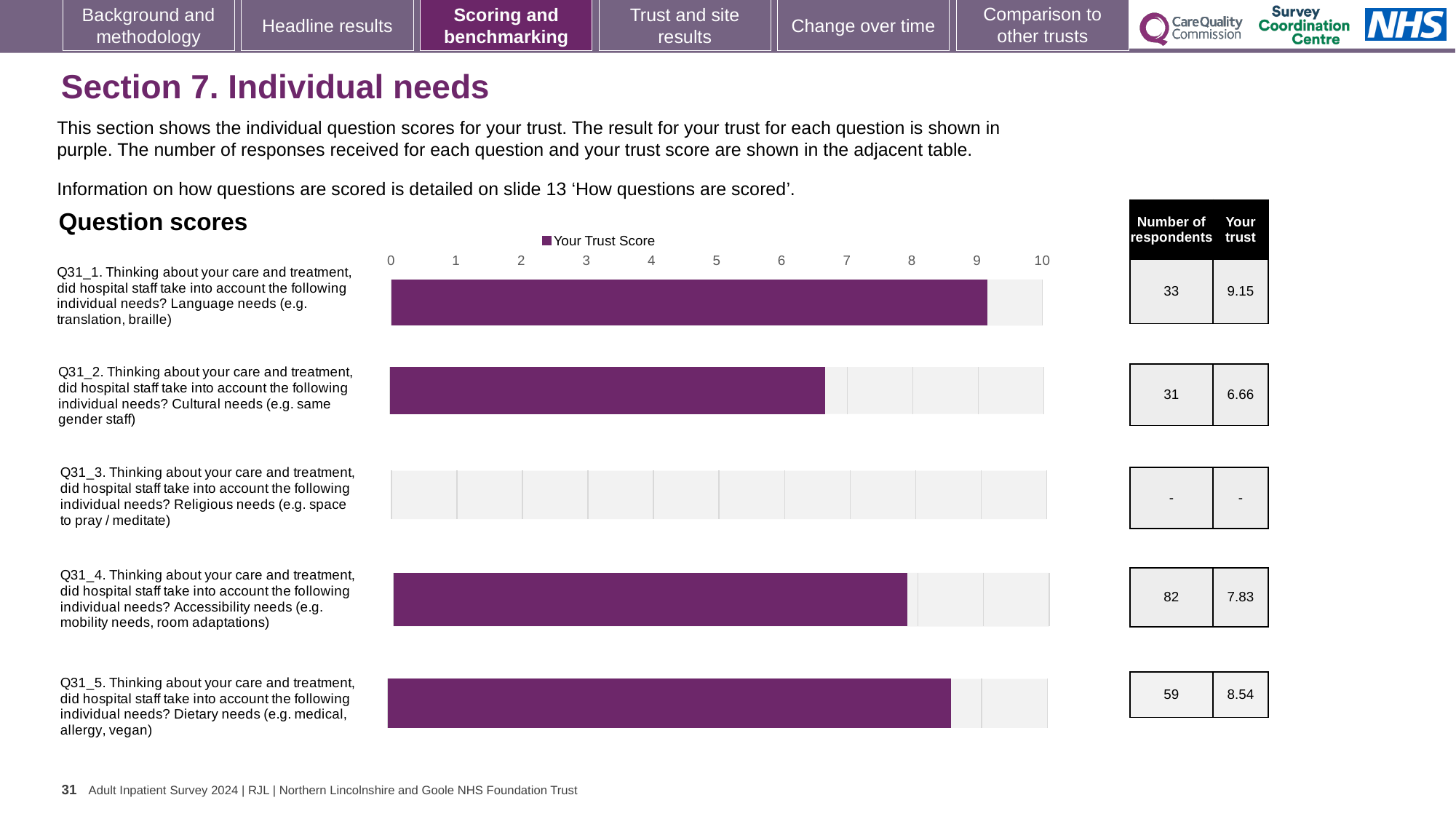
What type of chart is used to show the question scores? Bar chart What is the difference between the trust scores for Q31_1 and Q31_2? 2.49 Is the trust score for Q31_2 (Cultural needs) greater or less than 7? less Among the questions with a score shown, which has the lowest trust score? Q31_2 (Cultural needs) What is the trust score for Q31_2 (Cultural needs)? 6.66 Which question has the highest trust score? Q31_1 (Language needs) What is the trust score for Q31_5 (Dietary needs)? 8.54 How many respondents answered Q31_4 (Accessibility needs)? 82 How many questions are listed in the chart? 5 What is the trust score for Q31_4 (Accessibility needs)? 7.83 What is the trust score for Q31_1 (Language needs)? 9.15 Which has the larger trust score, Q31_4 (Accessibility needs) or Q31_5 (Dietary needs)? Q31_5 (Dietary needs)